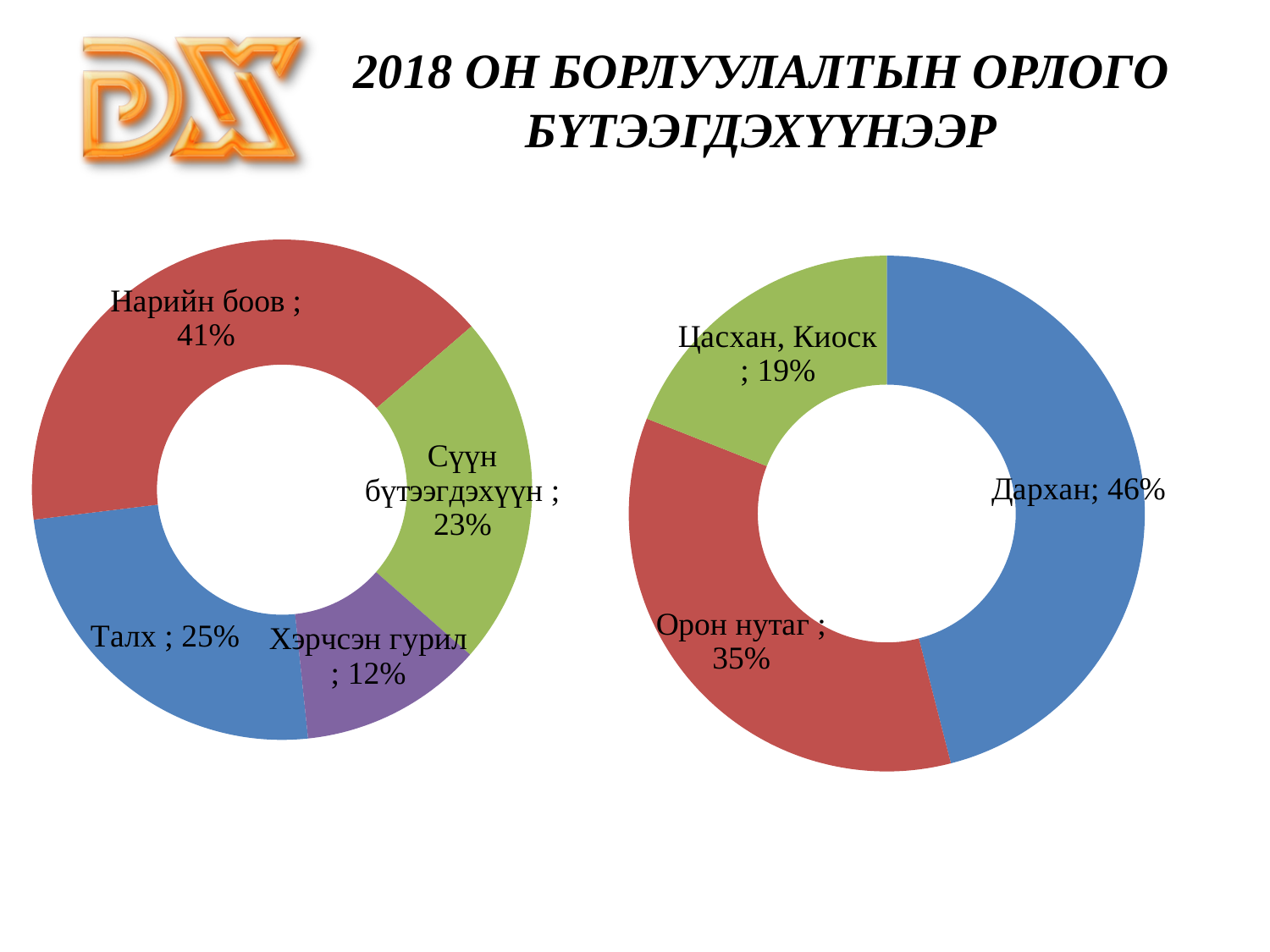
In the right doughnut chart, which category has the largest share? Дархан In the right doughnut chart, what is the difference in percentage points between Дархан and Орон нутаг? 11 percentage points In the left doughnut chart, which is larger: Талх or Сүүн бүтээгдэхүүн? Талх How many categories does the left doughnut chart show? 4 In the left doughnut chart, what is the difference in percentage points between Талх and Сүүн бүтээгдэхүүн? 2 percentage points In the left doughnut chart, which category has the largest share? Нарийн боов In the right doughnut chart, which category has the smallest share? Цасхан, Киоск In the right doughnut chart, what share does Орон нутаг have? 35% In the left doughnut chart, which category has the smallest share? Хэрчсэн гурил In the right doughnut chart, what share does Цасхан, Киоск have? 19% In the left doughnut chart, what share does Нарийн боов have? 41% In the left doughnut chart, what share does Хэрчсэн гурил have? 12%